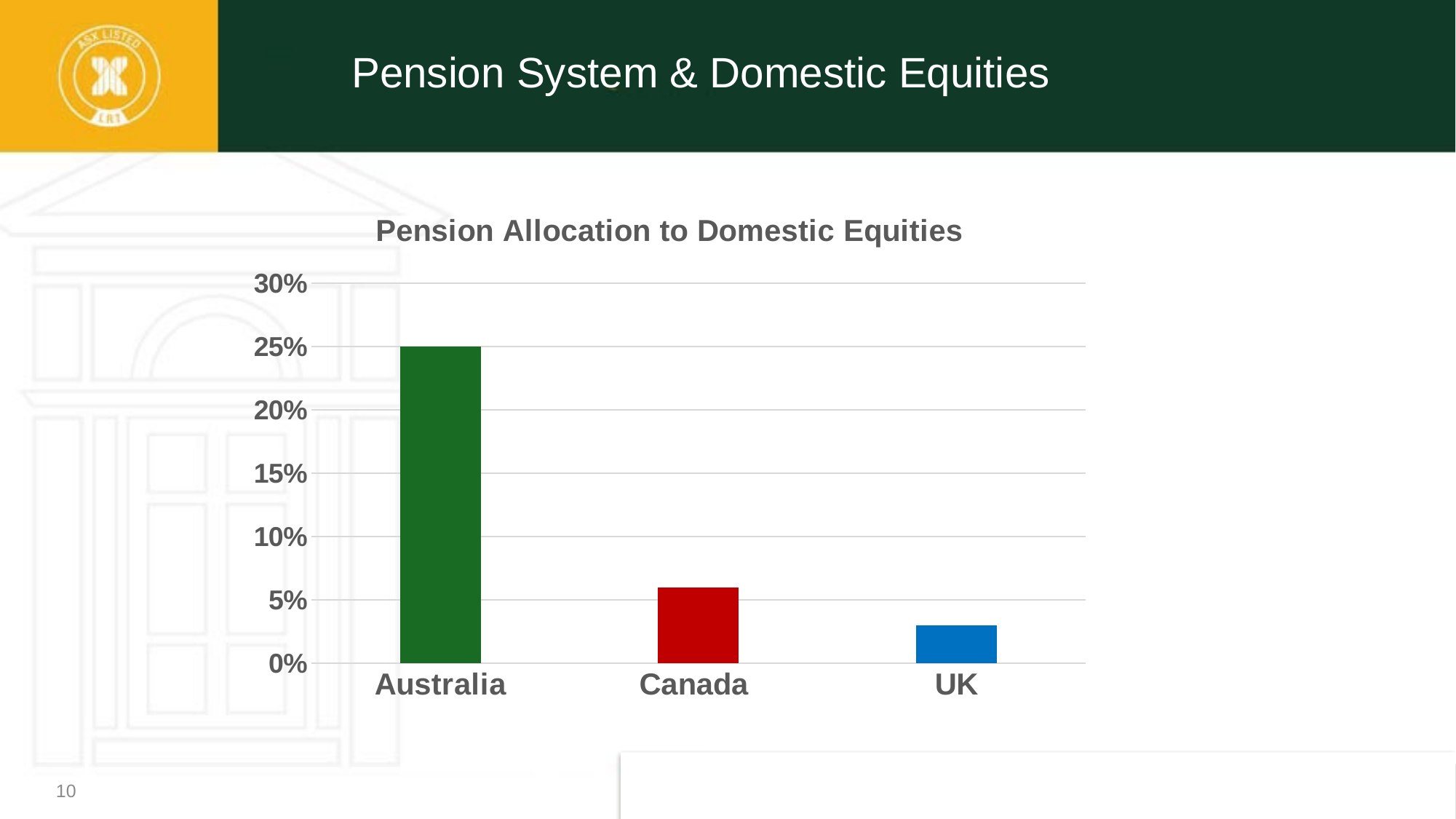
How many countries are shown in the chart? 3 Is the value for UK greater or less than 5%? less Is the value for Canada greater or less than 10%? less Which country has the highest pension allocation to domestic equities? Australia Is the value for Canada greater or less than 5%? greater What colour is the bar for Australia? green Which country has the lowest pension allocation to domestic equities? UK What is the title of the chart? Pension Allocation to Domestic Equities What type of chart is shown on the slide? bar chart Which has a larger pension allocation to domestic equities, Canada or UK? Canada What is the pension allocation to domestic equities for Australia? 25%